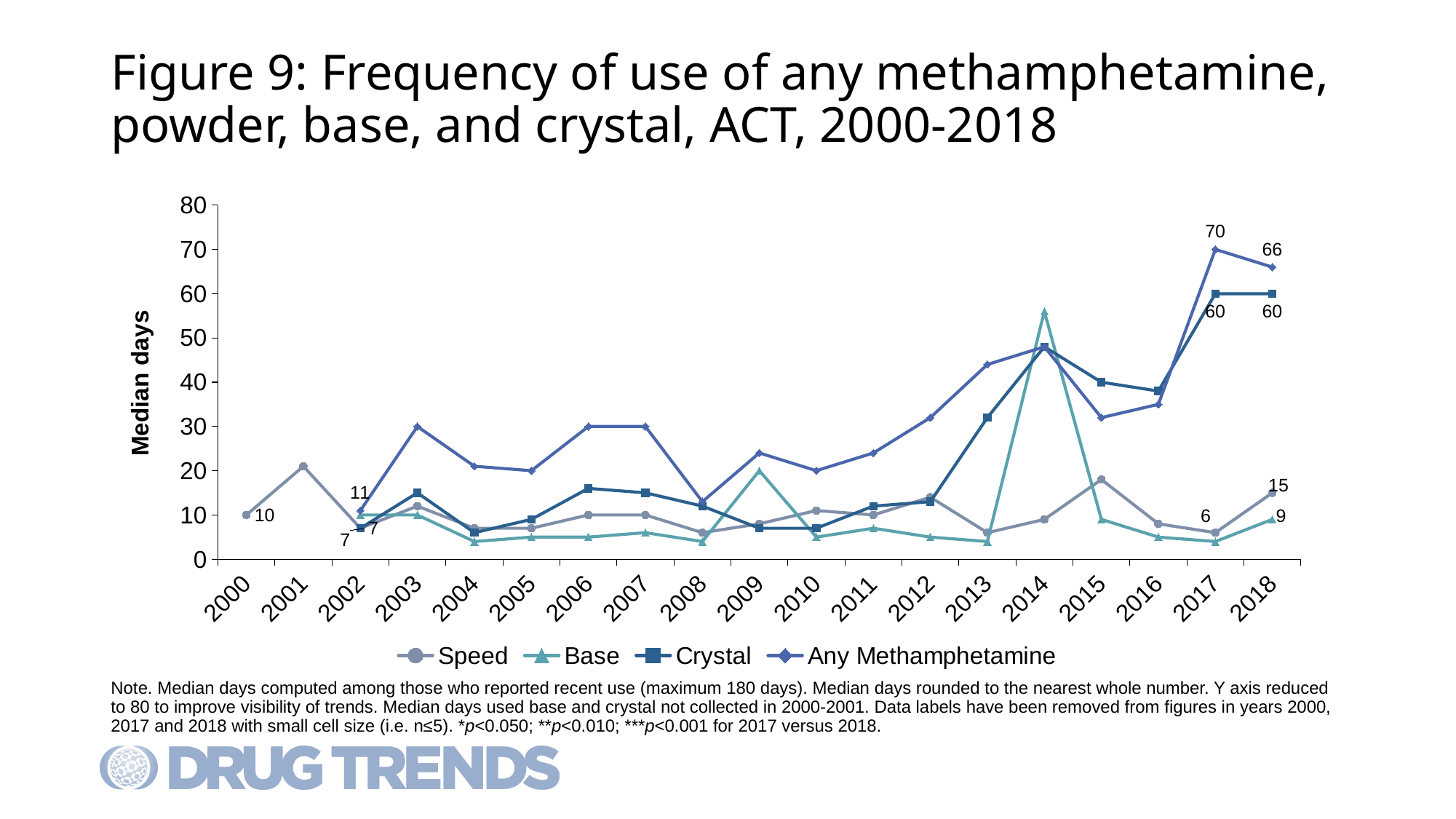
What kind of chart is shown on the slide? line chart Is the value for Base in 2014 greater or less than 50? greater By how many days did the Any Methamphetamine value fall from 2017 to 2018? 4 What is the median days value for Crystal in 2018? 60 What is the median days value for Speed in 2018? 15 What is the median days value for Any Methamphetamine in 2018? 66 How many series does the legend list? 4 What is the median days value for Speed in 2000? 10 What is the median days value for Any Methamphetamine in 2017? 70 What is the median days value for Base in 2018? 9 In 2018, which series has the larger value: Crystal or Speed? Crystal How many years are shown on the x axis? 19